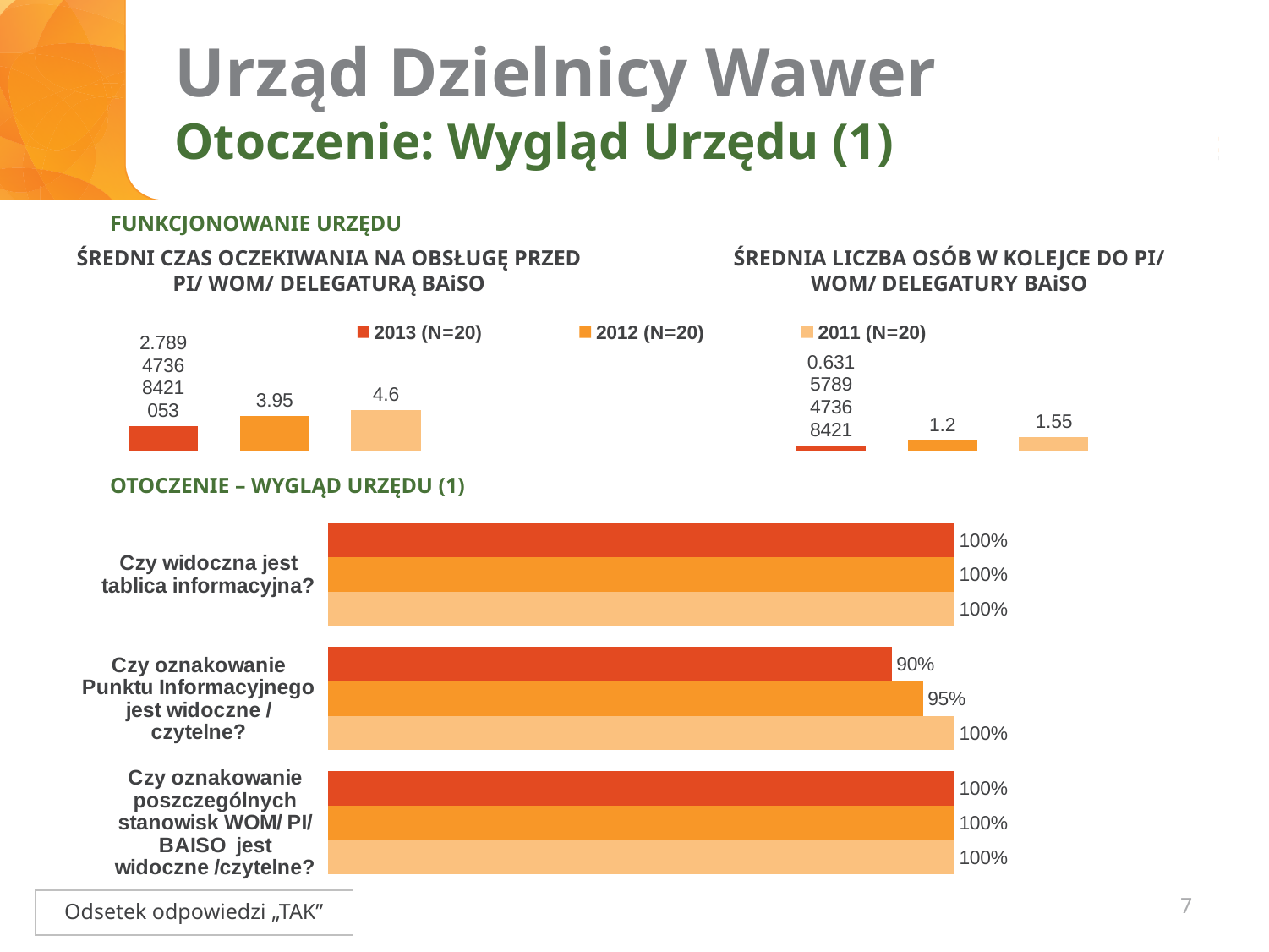
In the chart 'ŚREDNI CZAS OCZEKIWANIA NA OBSŁUGĘ PRZED PI/ WOM/ DELEGATURĄ BAiSO', what is the value for 2012 (N=20)? 3.95 In the chart 'ŚREDNI CZAS OCZEKIWANIA NA OBSŁUGĘ PRZED PI/ WOM/ DELEGATURĄ BAiSO', which year has the highest value? 2011 (N=20) In the bottom chart 'OTOCZENIE – WYGLĄD URZĘDU (1)', what is the 2013 (N=20) value for 'Czy oznakowanie Punktu Informacyjnego jest widoczne / czytelne?'? 90% What kind of chart is the bottom chart 'OTOCZENIE – WYGLĄD URZĘDU (1)'? Bar chart In the chart 'ŚREDNIA LICZBA OSÓB W KOLEJCE DO PI/ WOM/ DELEGATURY BAiSO', what is the value for 2011 (N=20)? 1.55 In the chart 'ŚREDNIA LICZBA OSÓB W KOLEJCE DO PI/ WOM/ DELEGATURY BAiSO', what is the value for 2012 (N=20)? 1.2 In the chart 'ŚREDNI CZAS OCZEKIWANIA NA OBSŁUGĘ PRZED PI/ WOM/ DELEGATURĄ BAiSO', what is the value for 2011 (N=20)? 4.6 In the chart 'ŚREDNIA LICZBA OSÓB W KOLEJCE DO PI/ WOM/ DELEGATURY BAiSO', which is larger: the value for 2012 (N=20) or 2011 (N=20)? 2011 (N=20) How many series does the legend above the top charts list? 3 In the bottom chart 'OTOCZENIE – WYGLĄD URZĘDU (1)', what is the 2012 (N=20) value for 'Czy oznakowanie Punktu Informacyjnego jest widoczne / czytelne?'? 95% In the chart 'ŚREDNIA LICZBA OSÓB W KOLEJCE DO PI/ WOM/ DELEGATURY BAiSO', what is the difference between the 2011 (N=20) and 2012 (N=20) values? 0.35 In the chart 'ŚREDNI CZAS OCZEKIWANIA NA OBSŁUGĘ PRZED PI/ WOM/ DELEGATURĄ BAiSO', which year has the lowest value? 2013 (N=20)